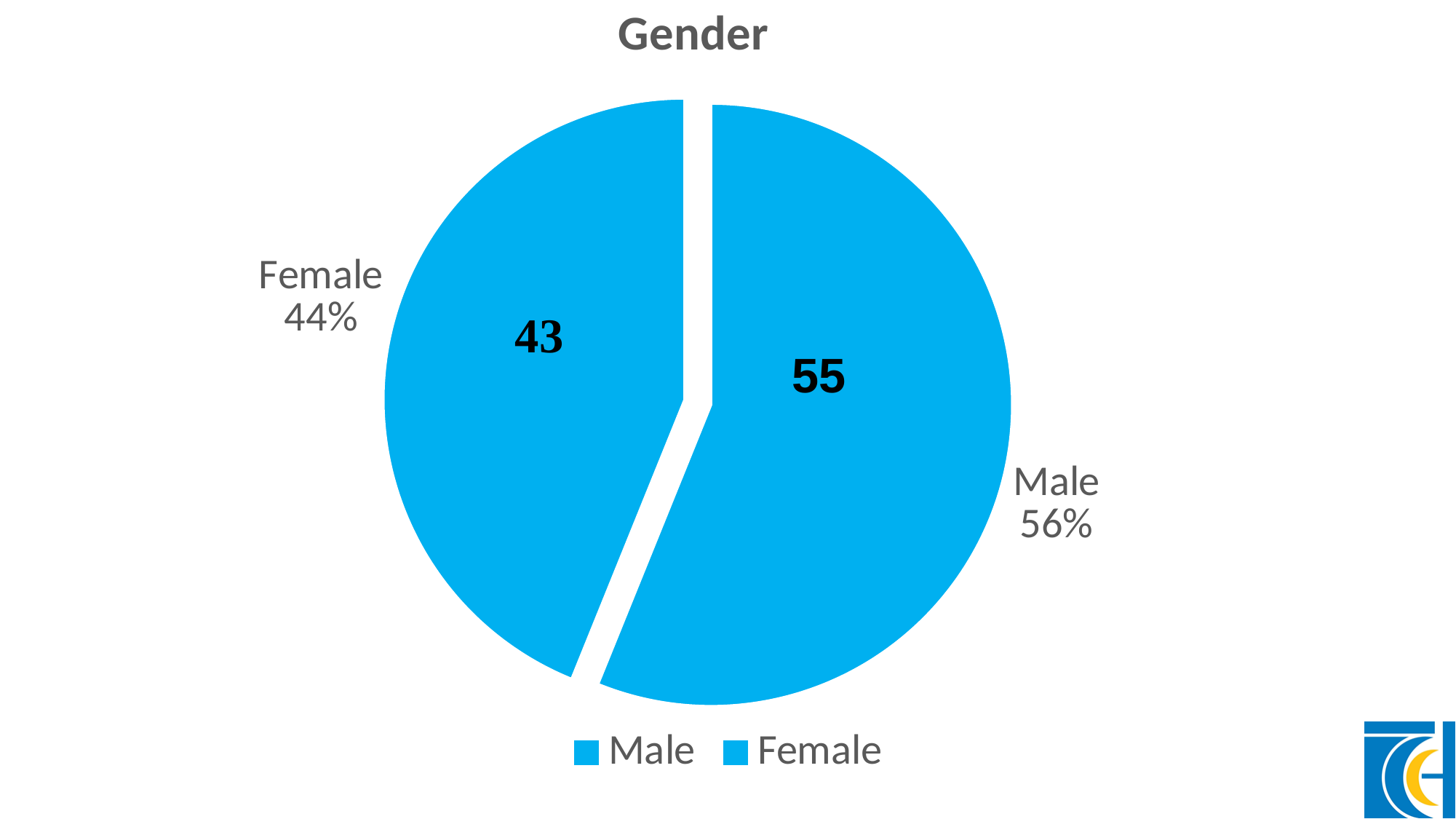
Which is larger, the value for Male or the value for Female? Male What is the total of the two slice values? 98 What kind of chart is shown on the slide? Pie chart Which category has the lowest value? Female Which category has the highest value? Male What is the value for Male? 55 What is the value for Female? 43 What is the title of the chart? Gender What percentage share does the Male slice have? 56% What is the difference between the Male and Female values? 12 How many categories are shown in the chart? 2 What percentage share does the Female slice have? 44%